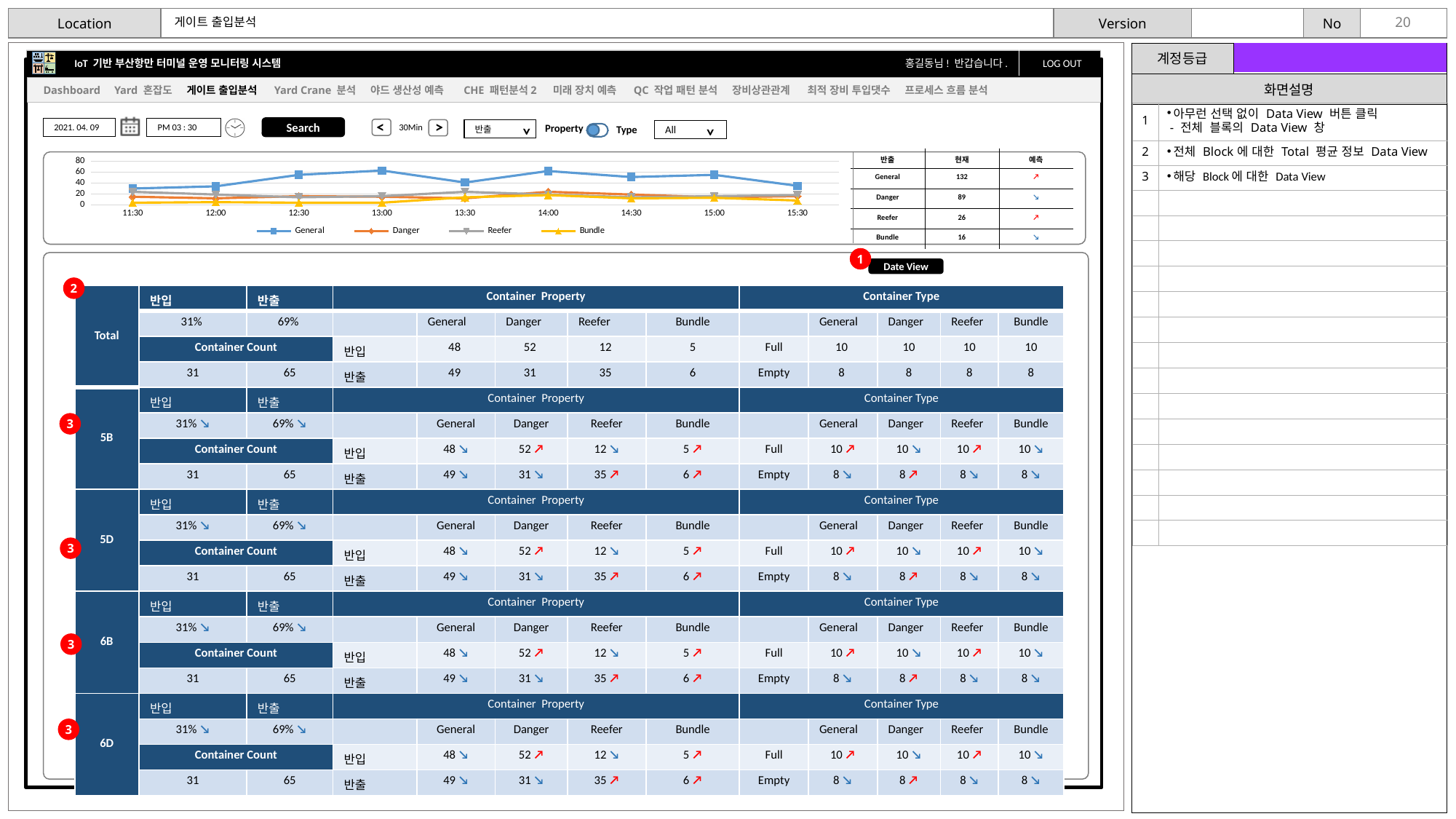
Is the value for General at 13:00 greater or less than 40? greater Is the value for Danger at 13:00 greater or less than 40? less Is the value for Bundle at 12:00 greater or less than 20? less What kind of chart is shown at the top of the slide? line chart Which series has the highest value at 14:00 in the line chart? General What is the first time label on the x axis of the line chart? 11:30 How many series does the legend of the line chart list? 4 What is the highest tick value shown on the y axis of the line chart? 80 How many time points are shown along the x axis of the line chart? 9 Which series has the highest value at 13:00 in the line chart? General At 13:00, which is larger: the value for General or the value for Reefer? General